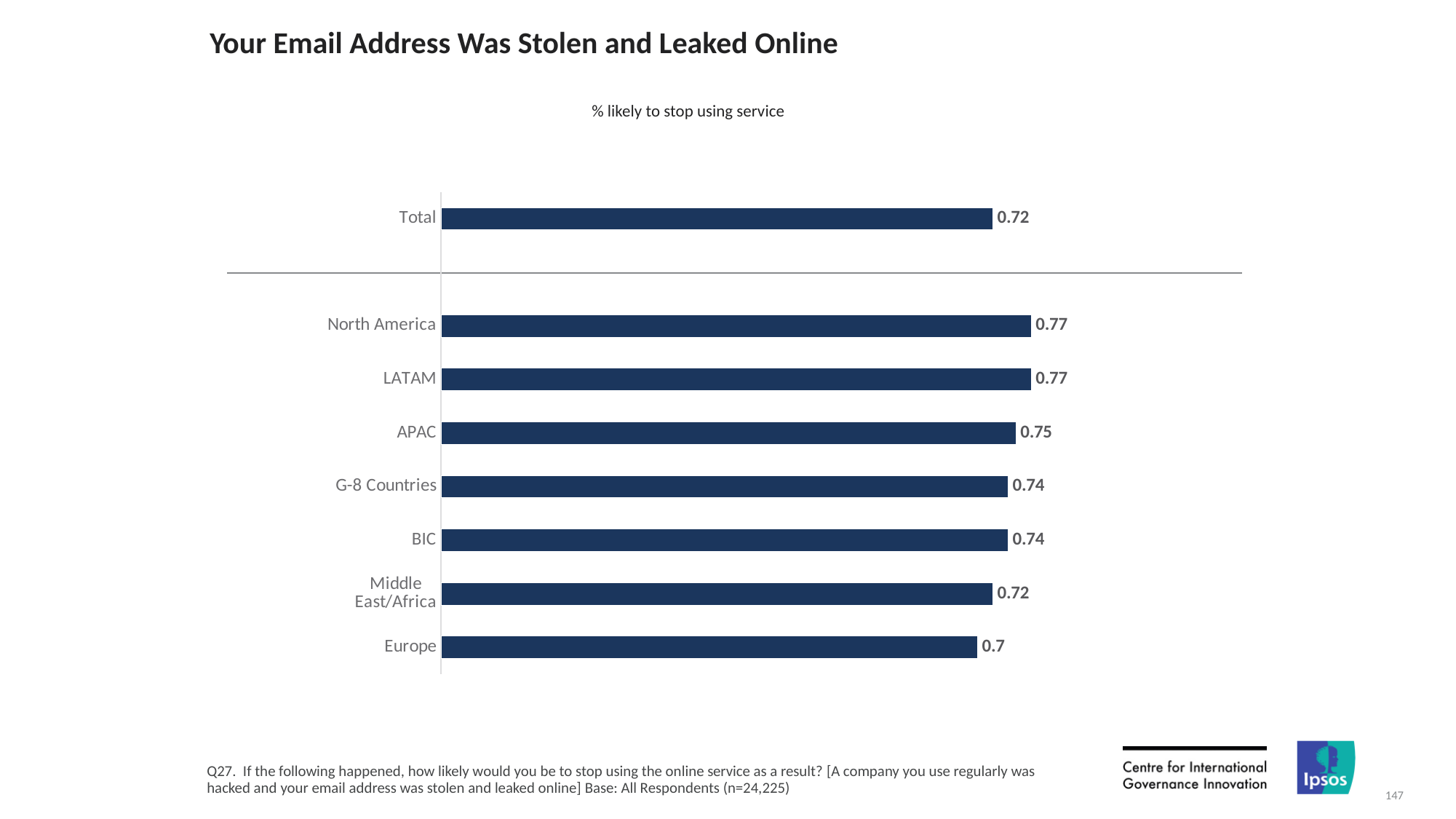
What is the value for Europe? 0.7 Which is larger, the value for LATAM or the value for BIC? LATAM Which region has the lowest value? Europe What is the difference between the values for North America and Europe? 0.07 How many bars are shown in the chart? 8 What is the title of the chart? Your Email Address Was Stolen and Leaked Online What is the value for APAC? 0.75 Which is larger, the value for Europe or the value for APAC? APAC What is the value for Middle East/Africa? 0.72 What is the value for Total? 0.72 What kind of chart is shown on the slide? Bar chart What is the difference between the values for APAC and G-8 Countries? 0.01